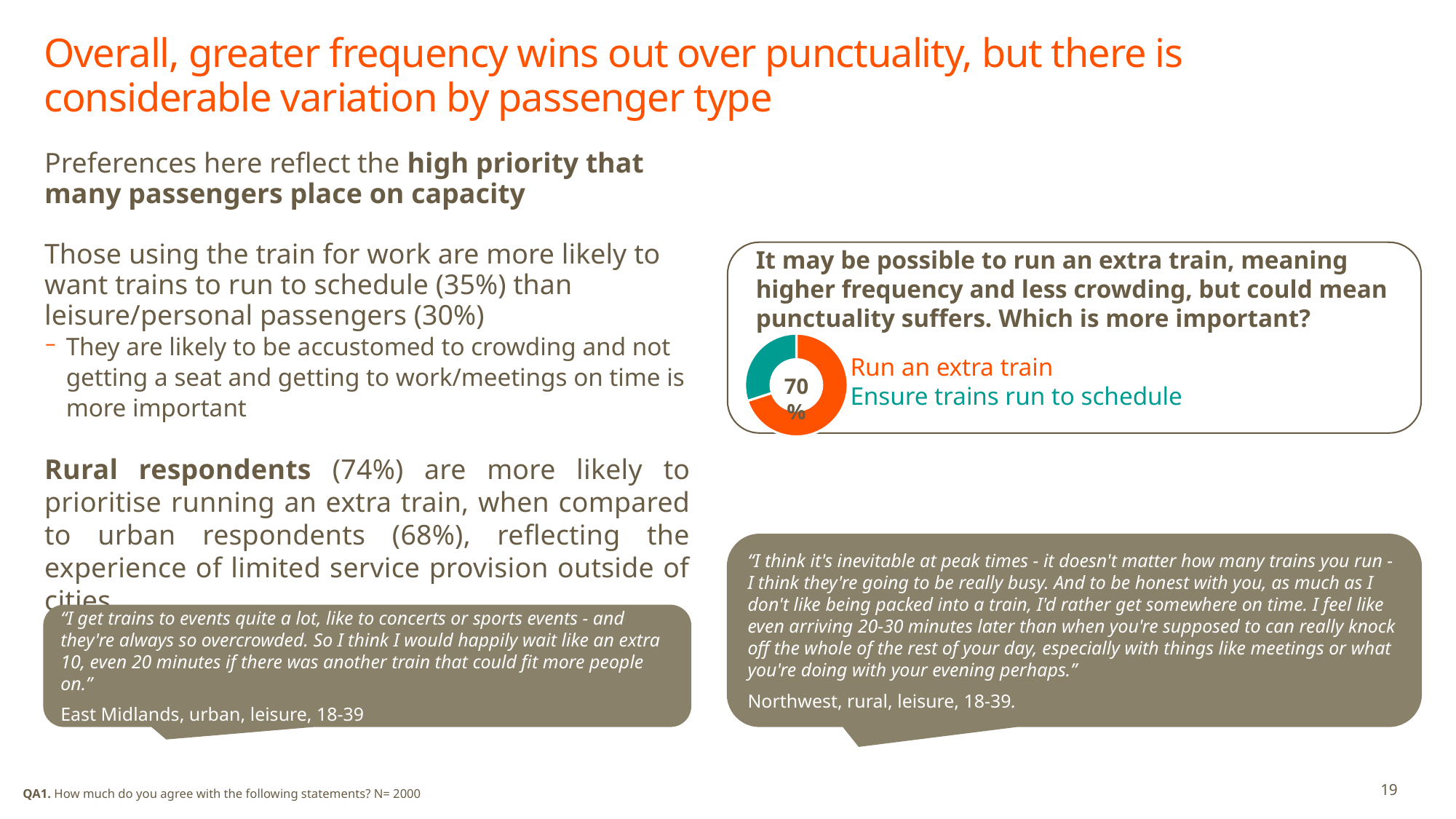
Which is larger in the pie chart: the share for 'Run an extra train' or the share for 'Ensure trains run to schedule'? Run an extra train What share of the pie chart is labelled with a data value, and what is that value? Run an extra train; 70% What colour represents 'Ensure trains run to schedule' in the pie chart? teal In the pie chart, which option has the largest share? Run an extra train How many entries does the legend of the pie chart list? 2 How many options (slices) does the pie chart show? 2 Is the share for 'Run an extra train' in the pie chart greater or less than 50%? greater What kind of chart is shown in the box asking which is more important, running an extra train or ensuring trains run to schedule? doughnut chart In the pie chart, which option has the smallest share? Ensure trains run to schedule What colour represents 'Run an extra train' in the pie chart? orange In the pie chart, what percentage of respondents chose 'Run an extra train'? 70%